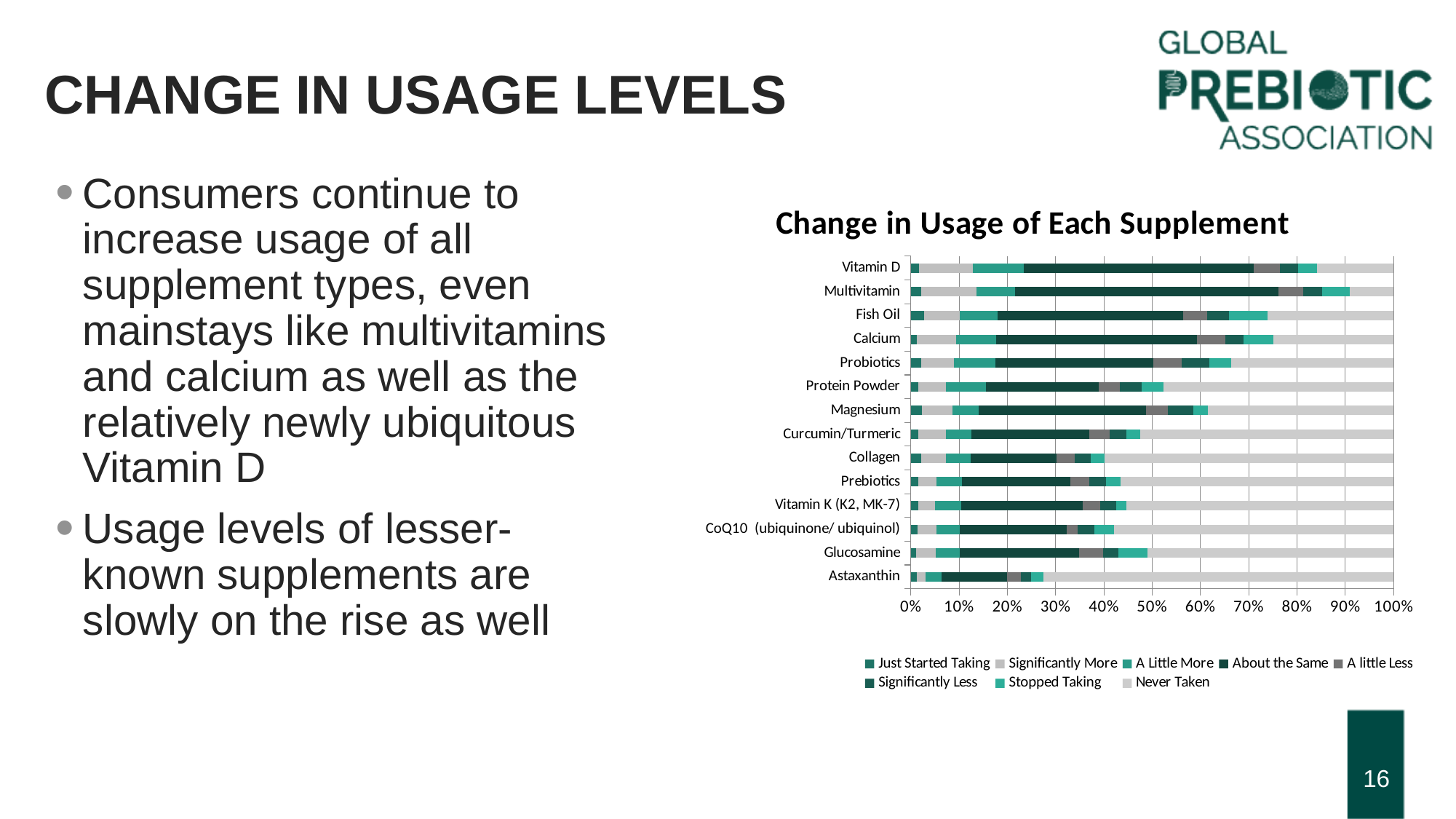
What kind of chart is shown on the slide? Stacked bar chart Which supplement has the largest Never Taken share? Astaxanthin What is the title of the chart? Change in Usage of Each Supplement Which supplement has the smallest Never Taken share? Multivitamin How many supplements are listed on the chart's vertical axis? 14 Is the point where the Never Taken segment begins for Collagen greater or less than 50%? less Which has the larger Never Taken share, Vitamin D or Magnesium? Magnesium Which supplement is listed at the top of the chart? Vitamin D How many series does the chart legend list? 8 Is the point where the Never Taken segment begins for Astaxanthin greater or less than 30%? less Is the point where the Never Taken segment begins for Multivitamin greater or less than 80%? greater Which has the larger Never Taken share, Fish Oil or Protein Powder? Protein Powder